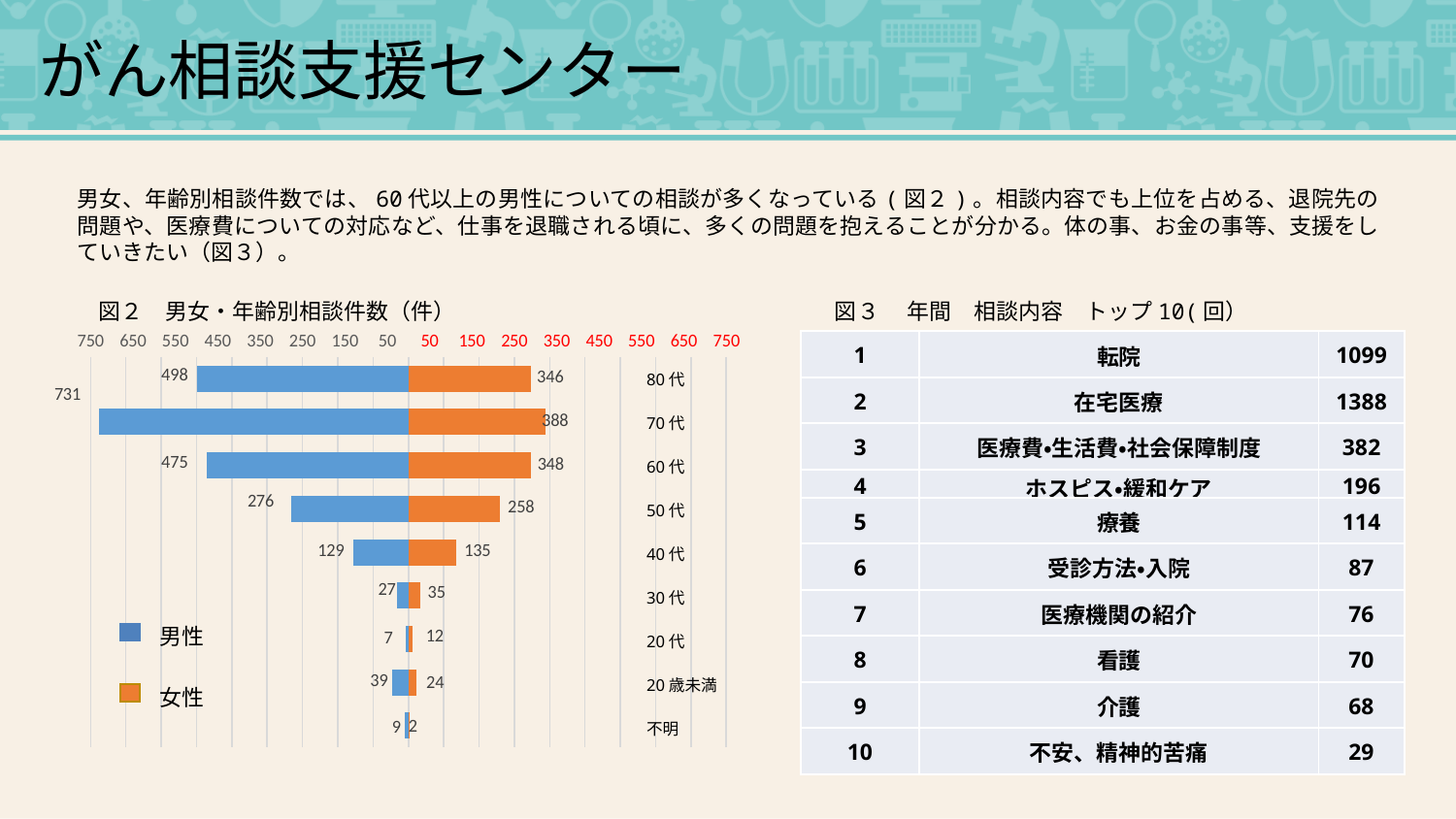
In 図2, what is the value for 男性 in the 70代 category? 731 In 図2, how many age categories are shown? 9 In 図2, how many series does the legend list? 2 What kind of chart is 図2? bar chart In 図2, what is the value for 女性 in the 80代 category? 346 In 図2, what is the difference between the 男性 values for 80代 and 60代? 23 In 図2, what is the difference between the 男性 and 女性 values in the 70代 category? 343 In 図2, what is the value for 男性 in the 50代 category? 276 In 図2, which colour represents 女性? orange In 図2, which is larger in the 40代 category, the 男性 value or the 女性 value? 女性 In 図2, which age category has the highest value for 男性? 70代 In 図2, which age category has the lowest value for 女性? 不明